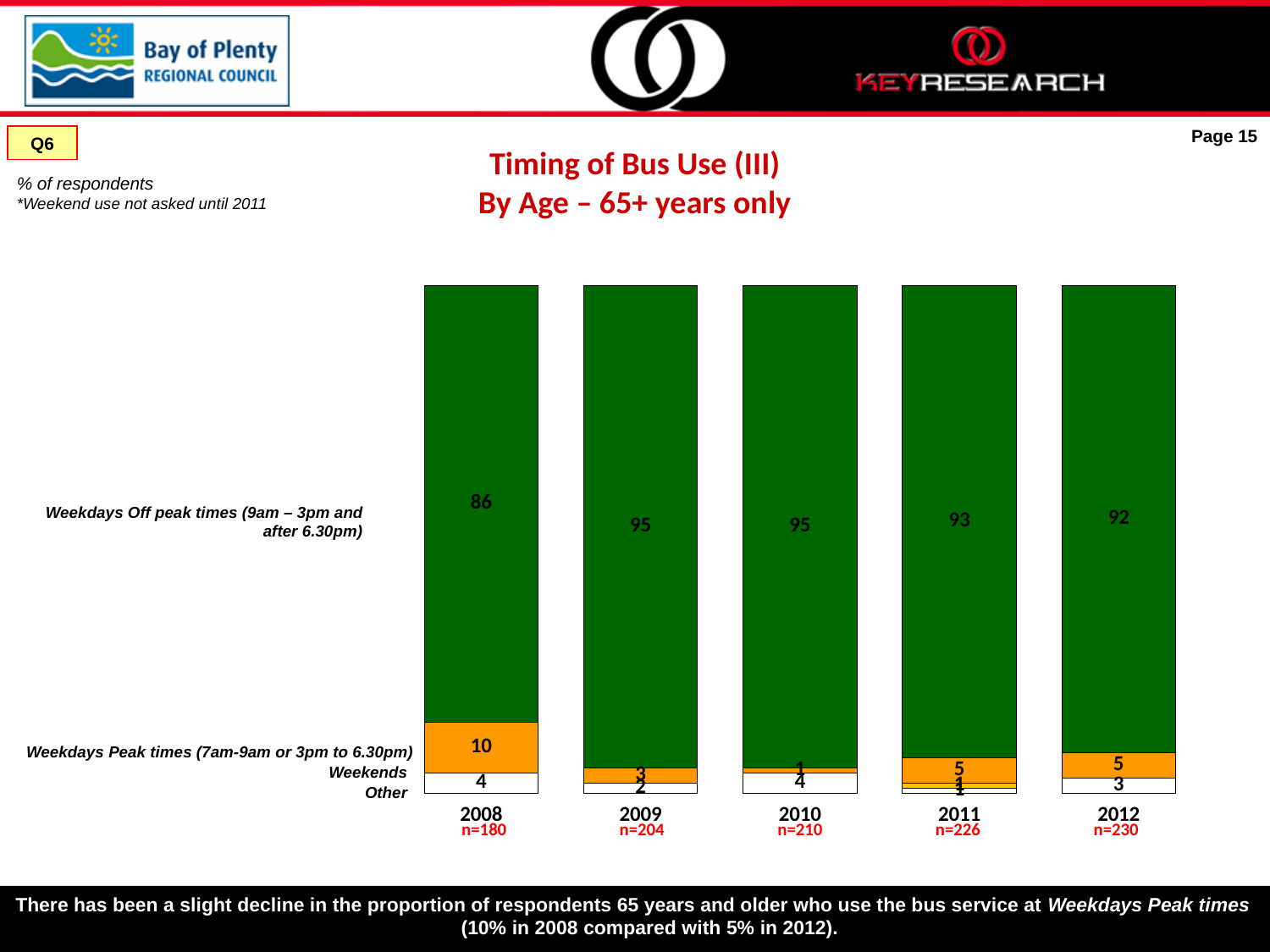
What is the value for Weekdays Peak times in 2012? 5 Which year has the larger Weekdays Peak times value, 2008 or 2012? 2008 What is the value for Other in 2008? 4 What is the value for Weekdays Peak times in 2008? 10 What kind of chart is shown on the slide? Stacked bar chart What is the difference between the Weekdays Peak times values for 2008 and 2012? 5 What percentage of respondents aged 65+ used the bus at Weekdays Off peak times in 2008? 86 What is the sample size (n) shown for 2012? n=230 By how much did the Weekdays Off peak times value increase from 2008 to 2012? 6 What percentage of respondents aged 65+ used the bus at Weekdays Off peak times in 2012? 92 Which year has the lowest value for Weekdays Off peak times? 2008 How many years are shown on the x axis of the chart? 5